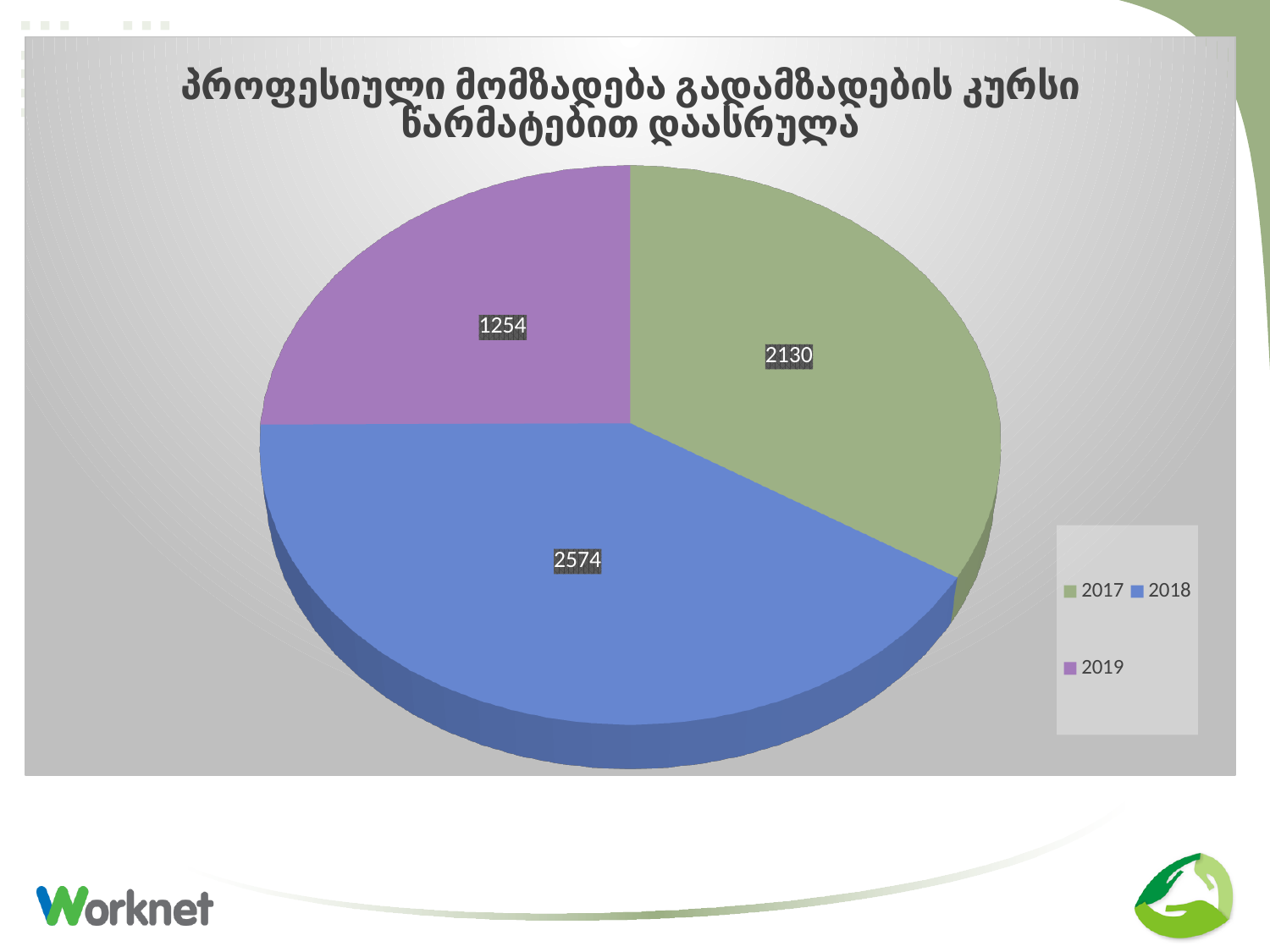
What type of chart is shown on the slide? pie chart What is the value for 2018? 2574 How many entries does the legend list? 3 What is the value for 2019? 1254 Which is larger, the value for 2017 or the value for 2019? 2017 What is the difference between the values for 2017 and 2019? 876 What is the value for 2017? 2130 How many slices does the pie chart have? 3 What colour is the slice for 2019? purple Which year has the largest slice of the pie? 2018 What is the difference between the values for 2018 and 2017? 444 Which year has the smallest slice of the pie? 2019